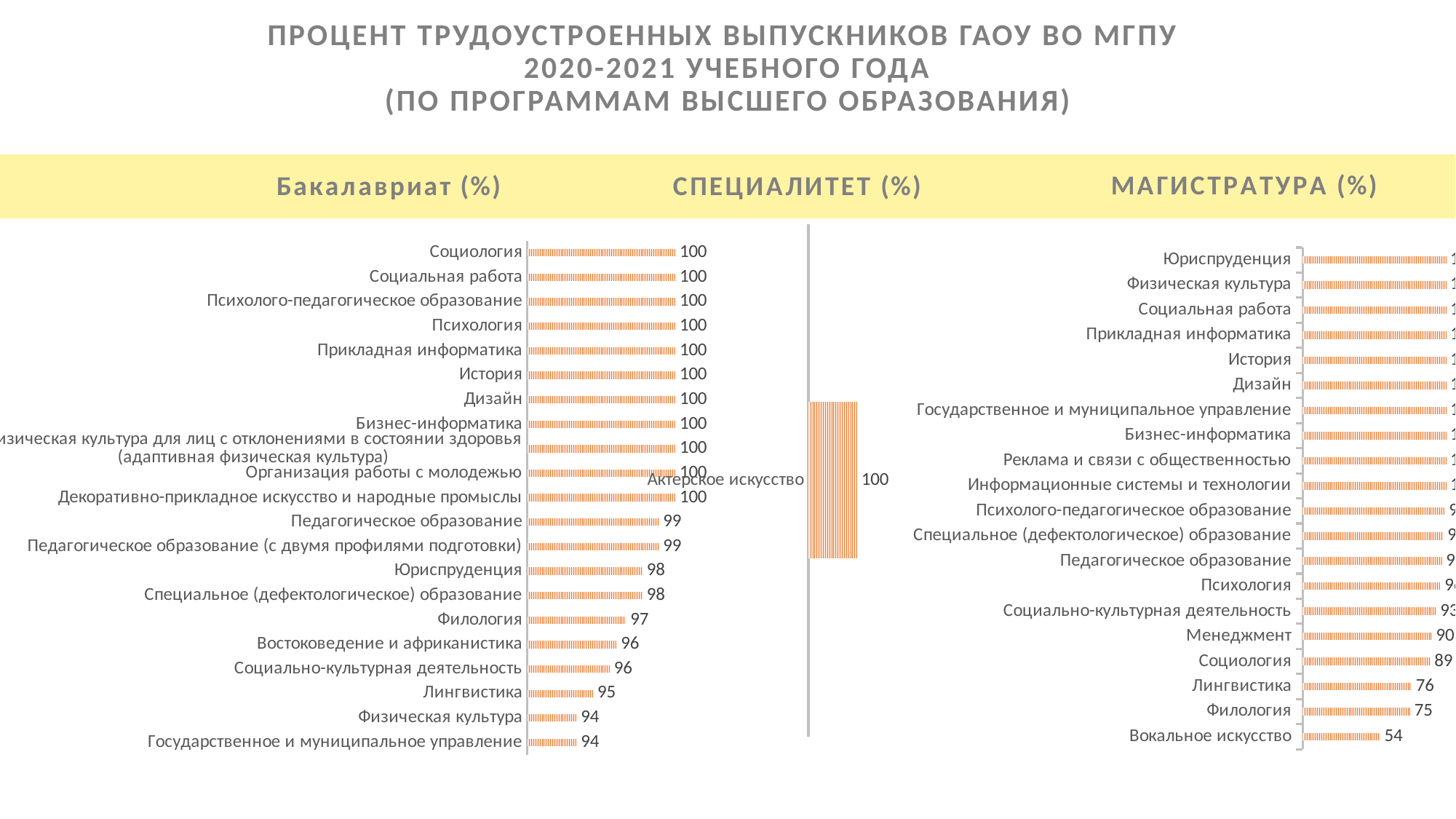
In the Бакалавриат (%) chart, what is the difference between the values for Филология and Лингвистика? 2 In the Бакалавриат (%) chart, what is the value for Юриспруденция? 98 In the Магистратура (%) chart, what is the value for Менеджмент? 90 In the Магистратура (%) chart, what is the value for Вокальное искусство? 54 In the Магистратура (%) chart, which category has the lowest value? Вокальное искусство In the Бакалавриат (%) chart, what is the value for Лингвистика? 95 In the Магистратура (%) chart, what is the difference between the values for Менеджмент and Вокальное искусство? 36 In the Магистратура (%) chart, which is larger, the value for Социология or the value for Лингвистика? Социология How many categories does the Специалитет (%) chart show? 1 What kind of chart is the Бакалавриат (%) chart? bar chart In the Бакалавриат (%) chart, what is the value for Филология? 97 In the Специалитет (%) chart, what is the value for Актерское искусство? 100